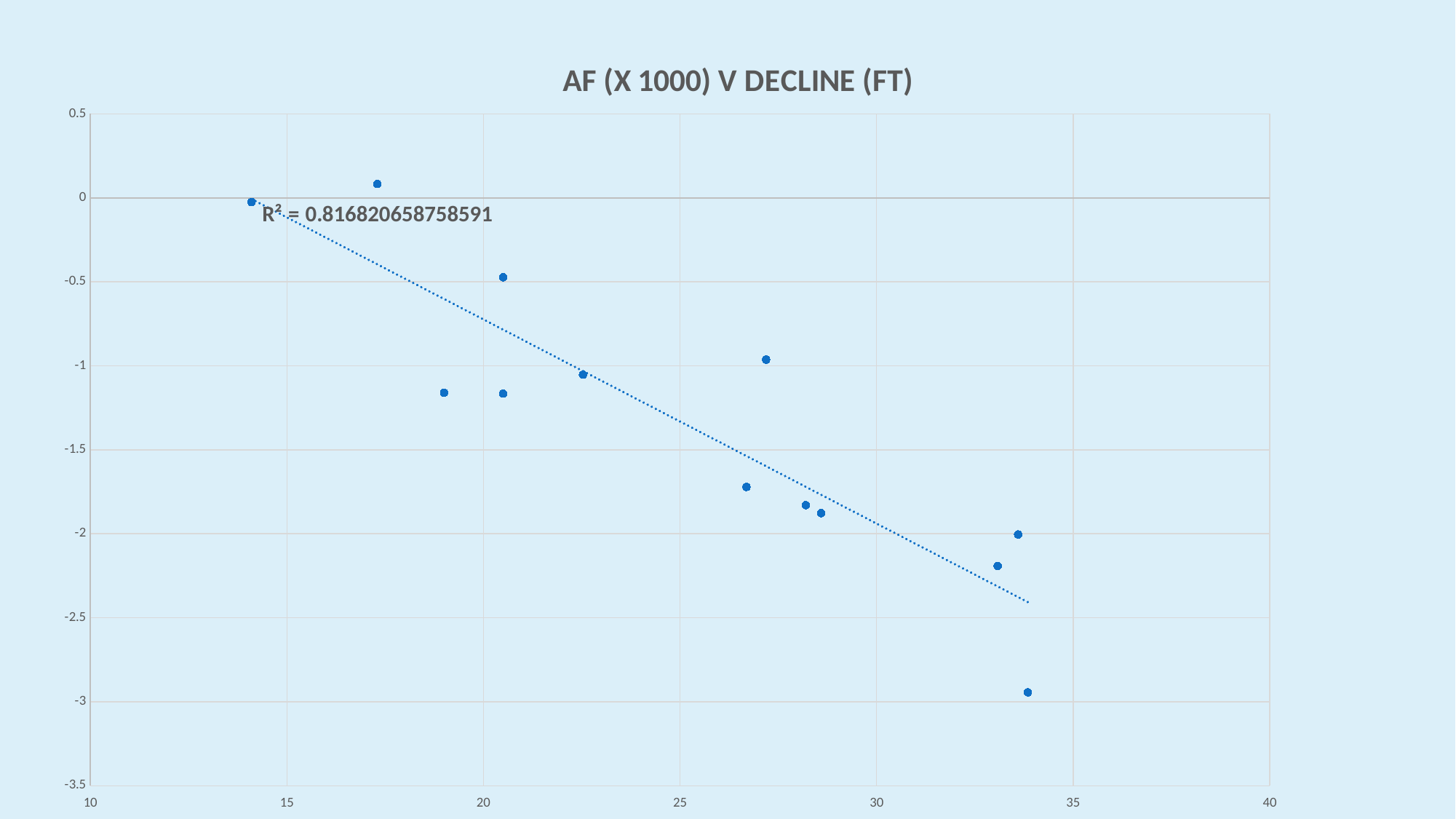
What is the title of the chart? AF (X 1000) V DECLINE (FT) Is the y value of the point at about x = 22.5 greater or less than -1.5? greater How many data points are plotted on the chart? 13 Is the y value of the lowest plotted point greater or less than -2.5? less Is the y value of the point at about x = 33 greater or less than -2? less Which has the larger y value: the point near x = 17 or the point near x = 34? the point near x = 17 What is the maximum value shown on the x-axis? 40 What R² value is printed on the chart? R² = 0.816820658758591 What kind of chart is shown on the slide? scatter chart Do the plotted values generally rise or fall as the x-axis value increases? fall Does the dotted trendline slope upward or downward from left to right? downward